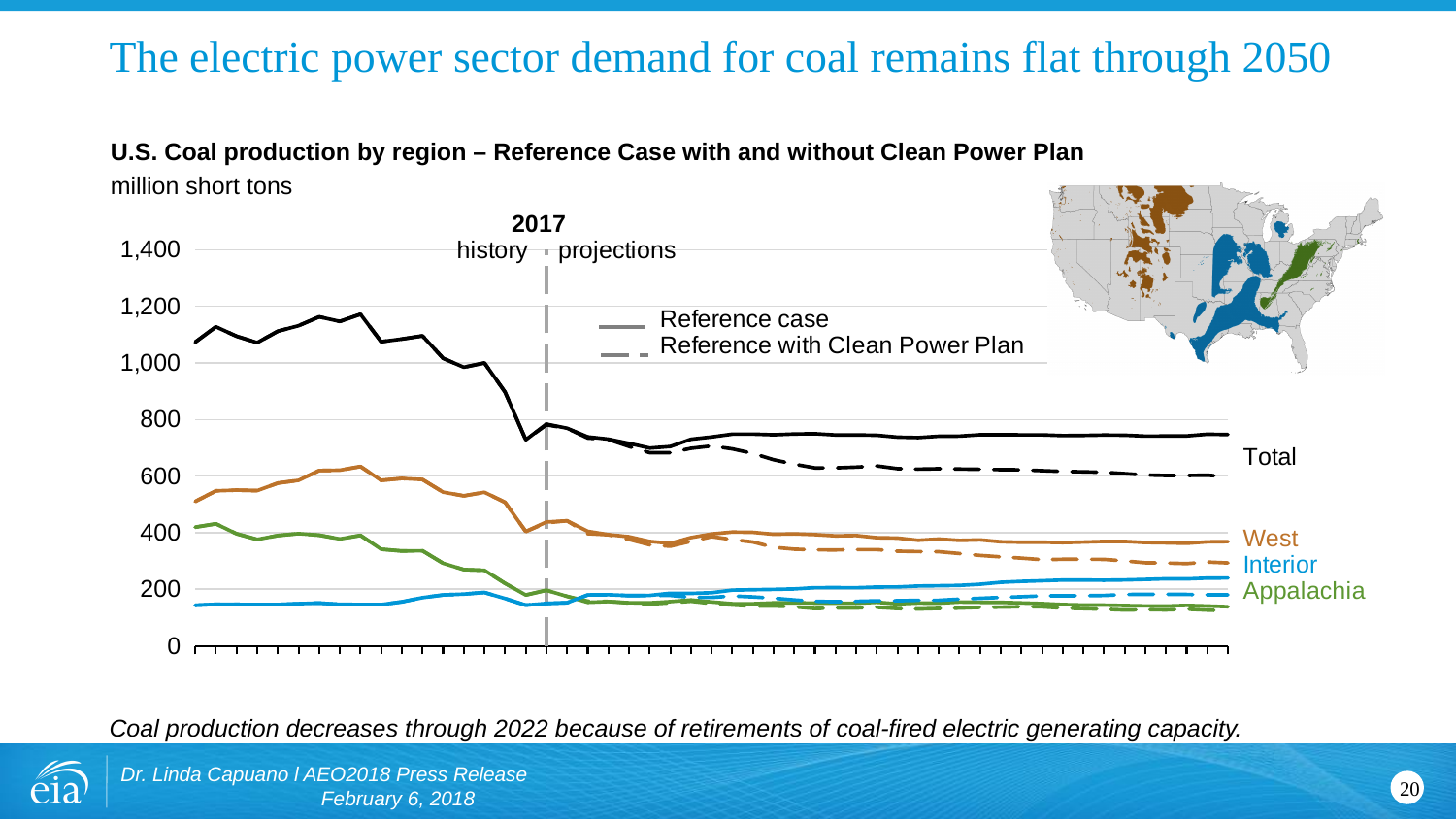
What unit is the y axis measured in? million short tons Which year separates history from projections on the chart? 2017 What kind of chart is shown on the slide? line chart Is the Appalachia value at the end of the projection period greater or less than 200? less What does the dashed line style represent according to the legend? Reference with Clean Power Plan How many entries does the legend list? 2 Is the Total value at the end of the projection period (Reference case) greater or less than 600? greater At the end of the projection period, which region has the higher production, West or Appalachia? West Is the Total value at the start of the history period greater or less than 1,000? greater Does the Total line rise or fall over the history period leading up to 2017? fall At the end of the projection period, which Total line is higher, the Reference case or the Reference with Clean Power Plan? Reference case